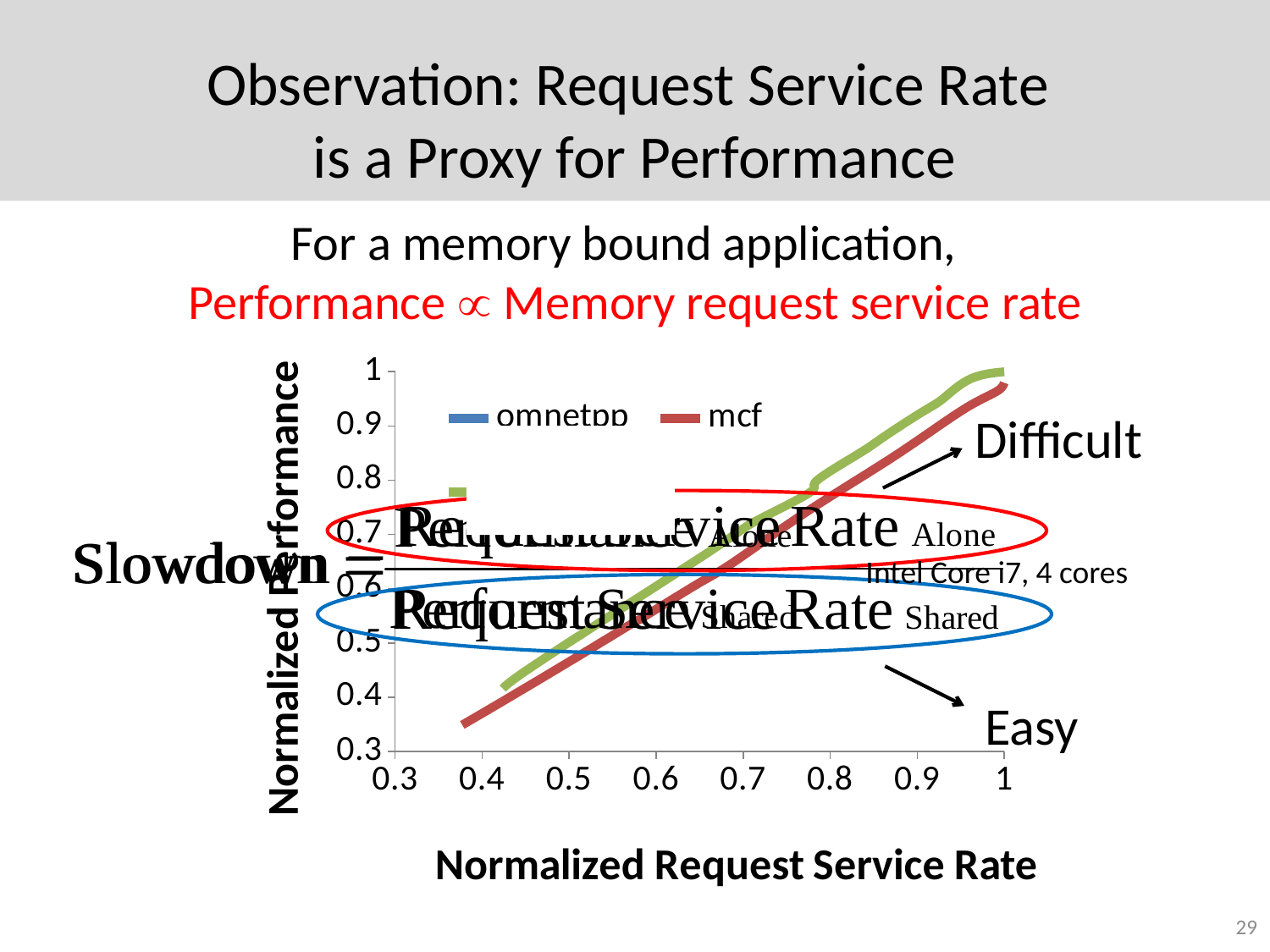
How many series does the chart legend list? 2 Is the Normalized Performance of mcf at a Normalized Request Service Rate of 0.4 greater or less than 0.5? less Is the Normalized Performance of mcf at a Normalized Request Service Rate of 1 greater or less than 0.9? greater Which two series are listed in the chart legend? omnetpp and mcf What kind of chart is shown on the slide? line chart Do the plotted values rise or fall as Normalized Request Service Rate increases along the x axis? rise What is the title of the x axis of the chart? Normalized Request Service Rate What is the lowest value shown on the y axis of the chart? 0.3